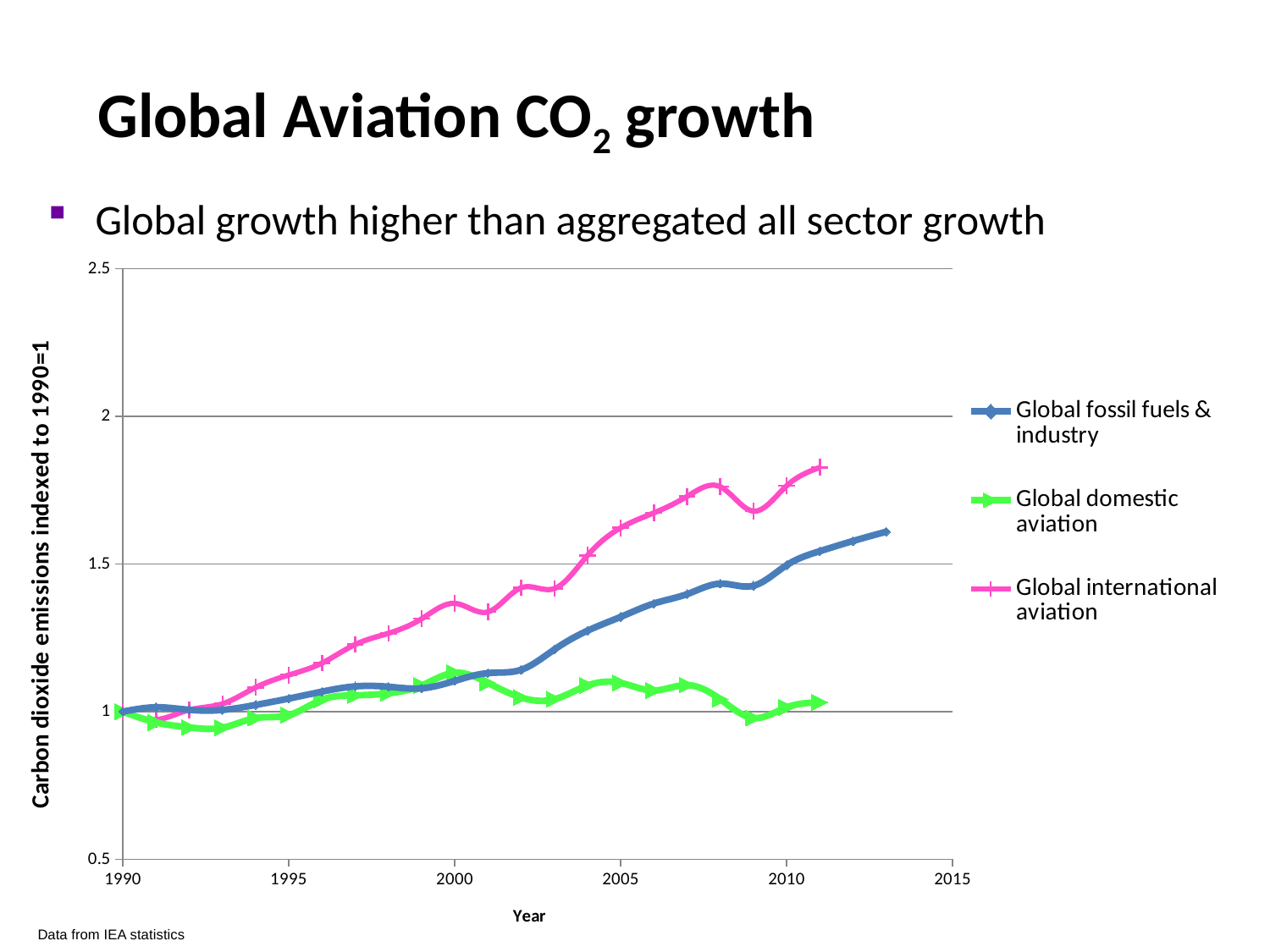
Which series has the lowest value in 2011? Global domestic aviation What is the title of the vertical axis? Carbon dioxide emissions indexed to 1990=1 What is the value of all three series in 1990? 1 Does the Global international aviation series generally rise or fall from 1990 to 2011? Rise How many series does the legend list? 3 In 2011, which is larger: Global international aviation or Global domestic aviation? Global international aviation Which series reaches the highest value on the chart? Global international aviation Is the value for Global fossil fuels & industry in 2005 greater or less than 1.5? less Is the value for Global international aviation in 2011 greater or less than 1.5? greater What kind of chart is shown on the slide? Line chart In 2008, which is larger: Global fossil fuels & industry or Global domestic aviation? Global fossil fuels & industry Is the value for Global domestic aviation in 1993 greater or less than 1? less